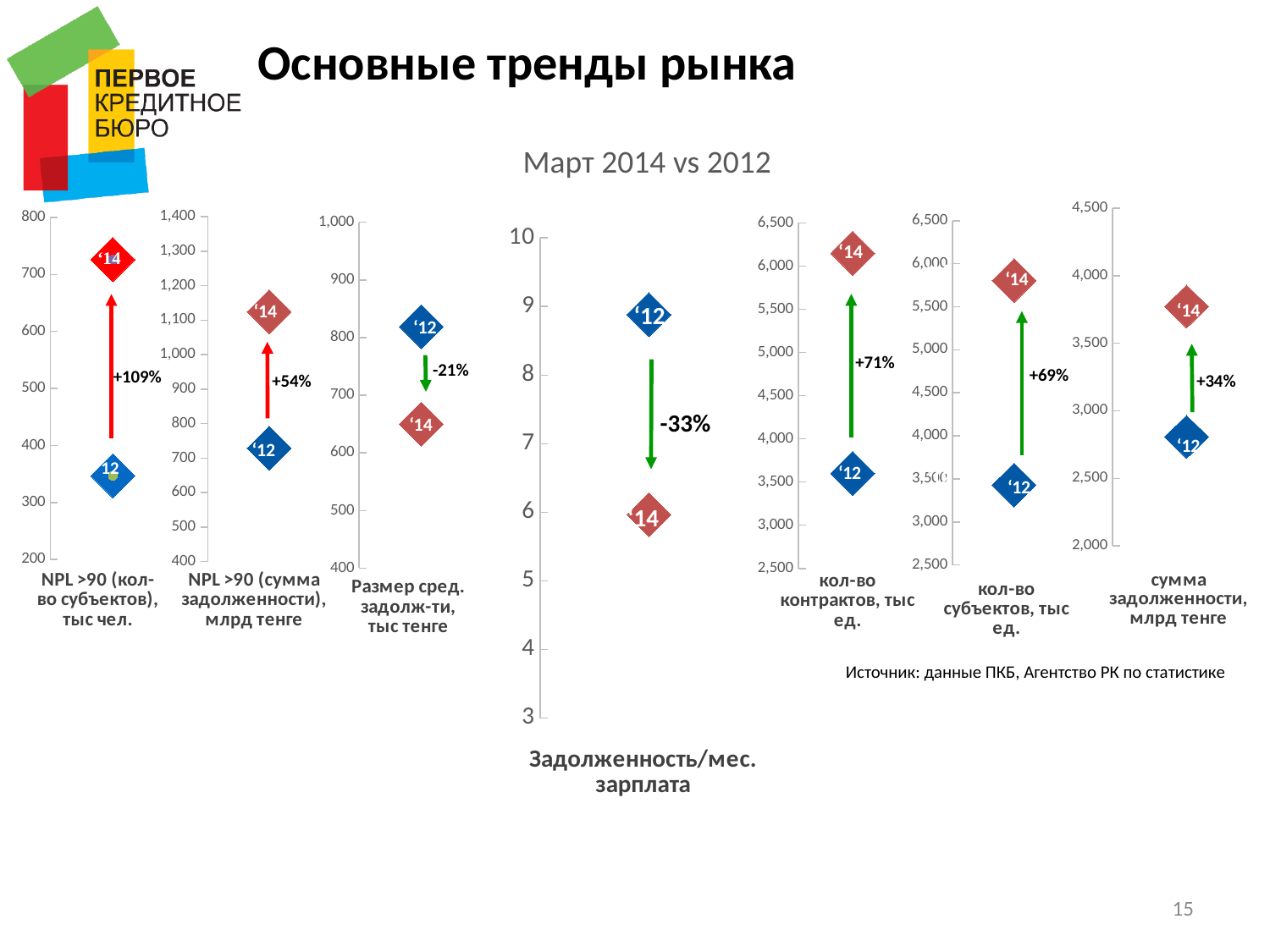
In the chart 'кол-во субъектов, тыс ед.', is the value for '12 greater or less than 4,000? less How many data points are plotted in the chart 'сумма задолженности, млрд тенге'? 2 In the chart 'Задолженность/мес. зарплата', is the value for '12 greater or less than 8? greater In the chart 'кол-во контрактов, тыс ед.', which point is higher, '12 or '14? '14 In the chart 'Размер сред. задолж-ти, тыс тенге', which point is higher, '12 or '14? '12 In the chart 'NPL >90 (кол-во субъектов), тыс чел.', what percentage change is printed between '12 and '14? +109% In the chart 'Задолженность/мес. зарплата', what percentage change is printed between '12 and '14? -33% In the chart 'кол-во контрактов, тыс ед.', what percentage change is printed between '12 and '14? +71% In the chart 'NPL >90 (кол-во субъектов), тыс чел.', is the value for '14 greater or less than 700? greater In the chart 'сумма задолженности, млрд тенге', what percentage change is printed between '12 and '14? +34% In the chart 'Размер сред. задолж-ти, тыс тенге', what percentage change is printed between '12 and '14? -21% In the chart 'NPL >90 (сумма задолженности), млрд тенге', what percentage change is printed between '12 and '14? +54%